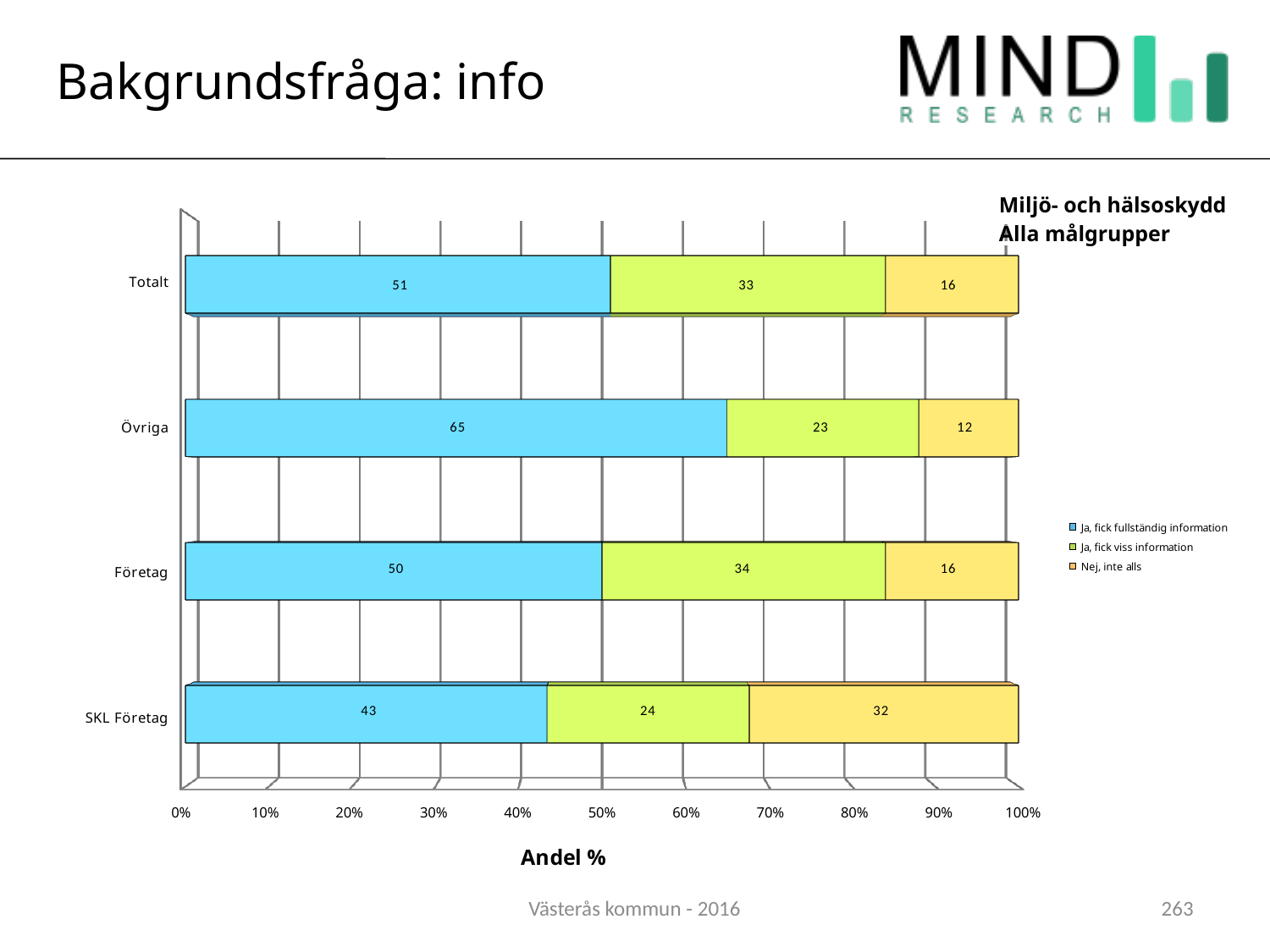
How many series does the legend list? 3 How many categories are shown on the y axis? 4 What is the x-axis title of the chart? Andel % What is the total of the stacked bar for Totalt? 100 What is the value for 'Nej, inte alls' for SKL Företag? 32 Which category has the lowest value for 'Nej, inte alls'? Övriga Which category has the highest value for 'Ja, fick fullständig information'? Övriga What kind of chart is shown on the slide? Stacked bar chart What is the difference between the 'Ja, fick fullständig information' values for Övriga and SKL Företag? 22 Which is larger: the 'Nej, inte alls' value for SKL Företag or for Totalt? SKL Företag What is the value for 'Ja, fick viss information' for Företag? 34 What is the value for 'Ja, fick fullständig information' for Övriga? 65